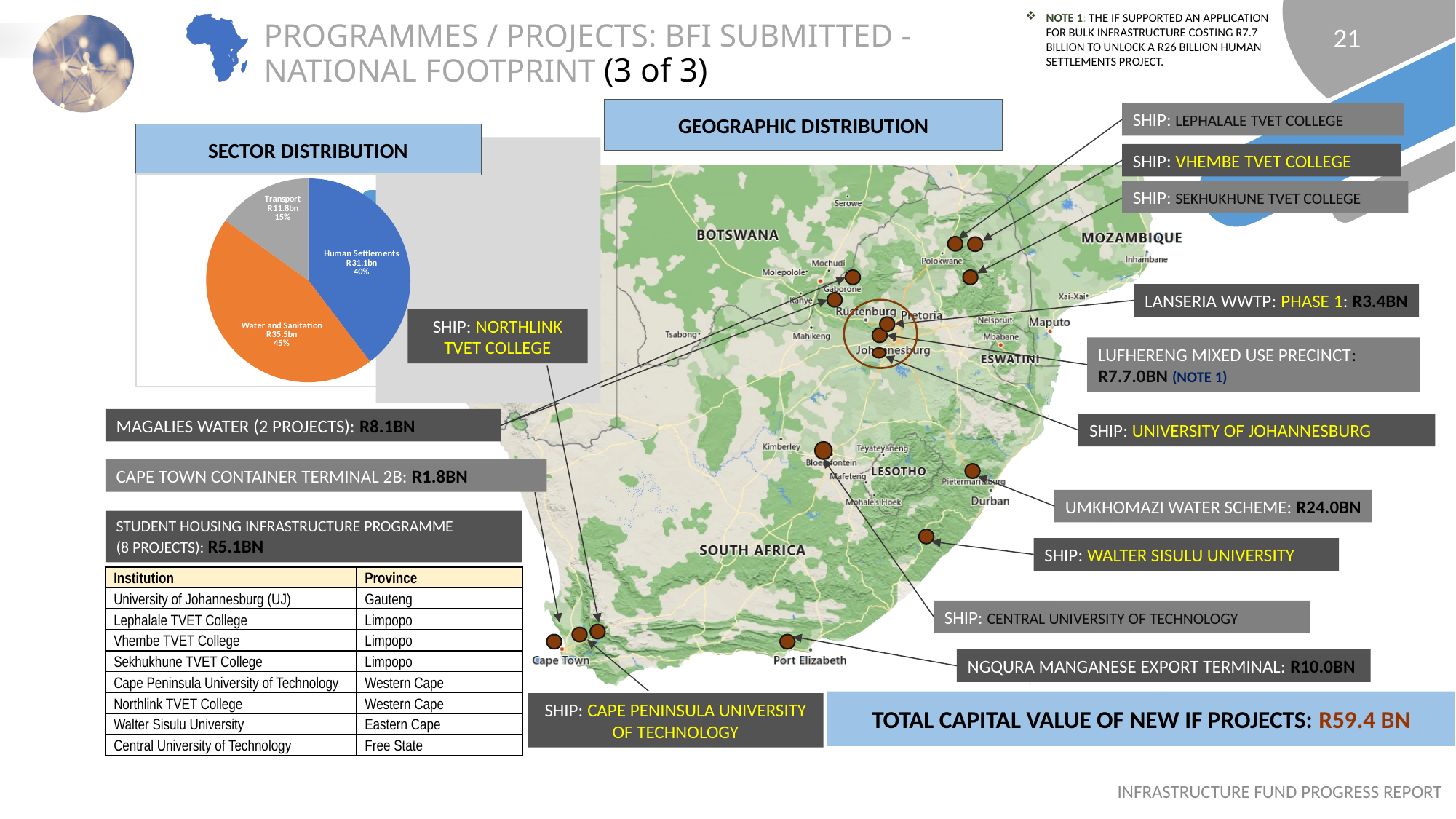
In the Sector Distribution pie chart, what percentage share does Human Settlements have? 40% What type of chart is shown under the Sector Distribution heading? pie chart How many slices does the Sector Distribution pie chart have? 3 Which sector has the smallest slice in the Sector Distribution pie chart? Transport Which sector has the largest slice in the Sector Distribution pie chart? Water and Sanitation In the Sector Distribution pie chart, what percentage share does Transport have? 15% In the Sector Distribution pie chart, what value is shown for Water and Sanitation? R35.5bn In the Sector Distribution pie chart, which is larger: Human Settlements or Transport? Human Settlements In the Sector Distribution pie chart, what value is shown for Transport? R11.8bn In the Sector Distribution pie chart, what percentage share does Water and Sanitation have? 45% In the Sector Distribution pie chart, what is the difference in percentage share between Water and Sanitation and Human Settlements? 5% In the Sector Distribution pie chart, what value is shown for Human Settlements? R31.1bn